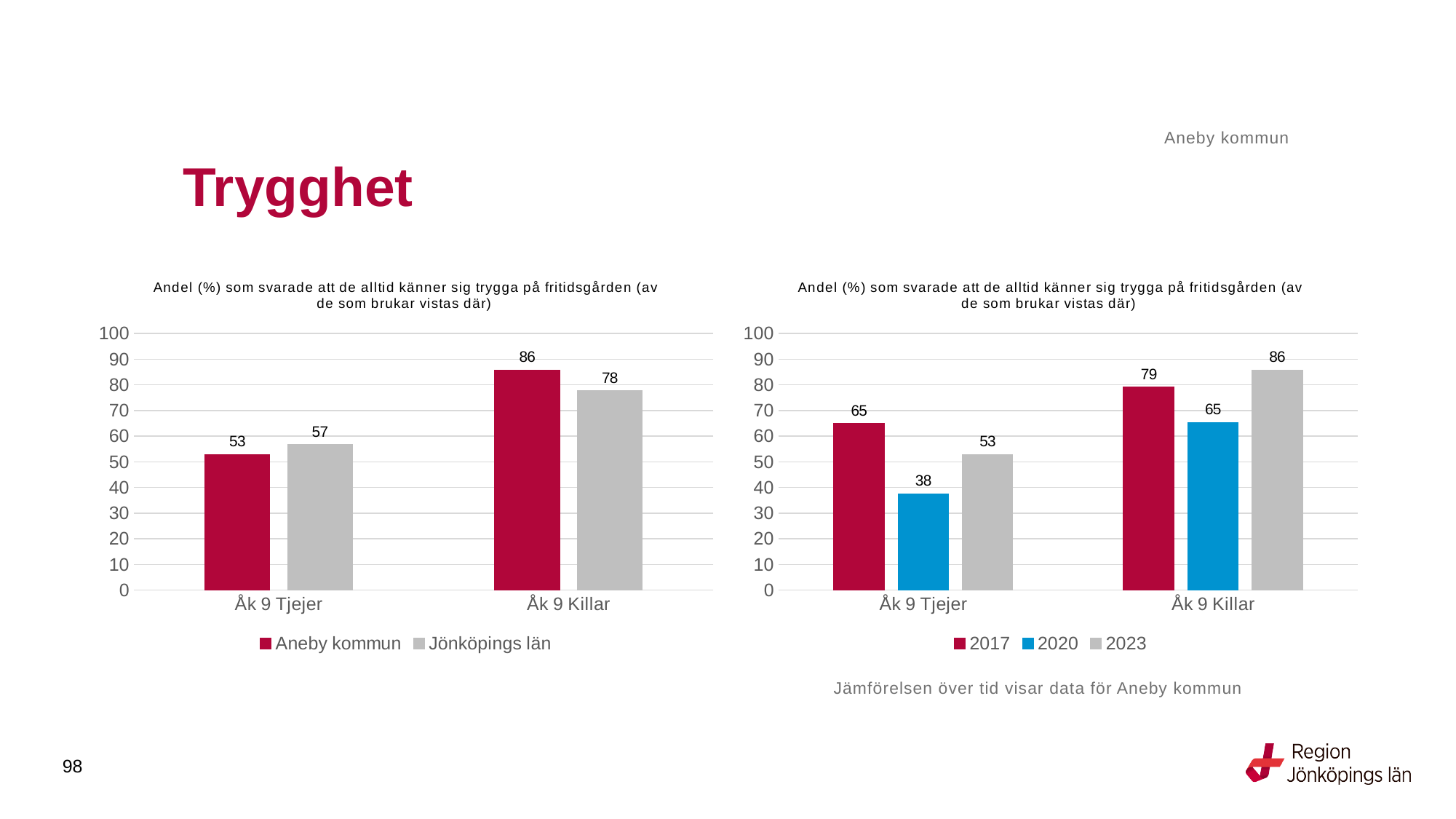
In the right chart, how many categories are shown on the x axis? 2 In the left chart, what is the value for Jönköpings län for Åk 9 Killar? 78 In the right chart, how many series does the legend list? 3 In the left chart, what is the value for Aneby kommun for Åk 9 Tjejer? 53 In the right chart, which year has the lowest value for Åk 9 Tjejer? 2020 In the right chart, what is the value for 2023 for Åk 9 Killar? 86 In the right chart, what is the value for 2020 for Åk 9 Tjejer? 38 In the right chart, what is the difference between 2017 and 2020 for Åk 9 Killar? 14 In the left chart, which is larger for Åk 9 Tjejer: Aneby kommun or Jönköpings län? Jönköpings län In the left chart, what is the difference between Aneby kommun and Jönköpings län for Åk 9 Killar? 8 In the left chart, how many series does the legend list? 2 What kind of chart is the left chart? bar chart